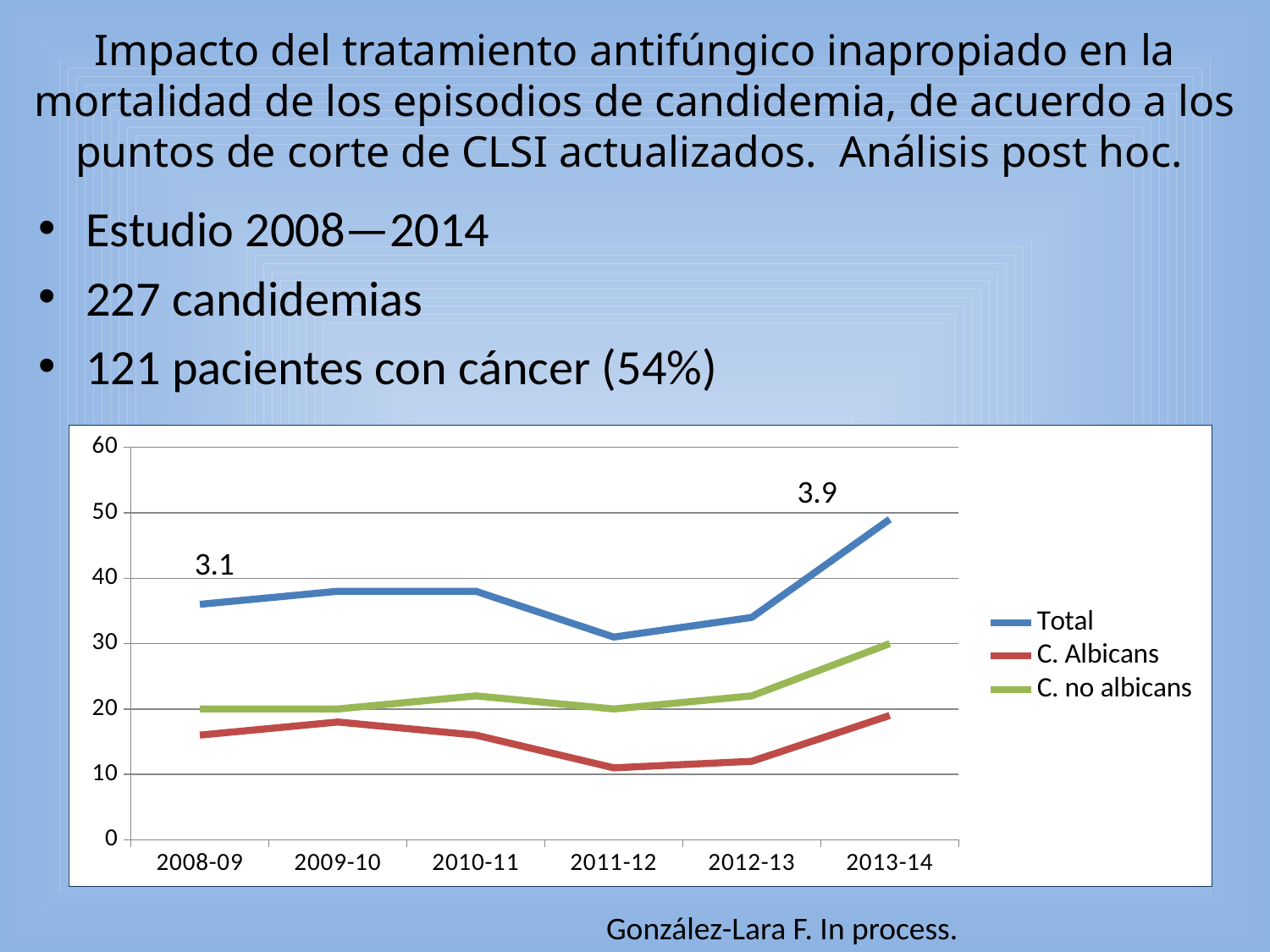
How many periods are shown along the x axis of the chart? 6 What are the three entries listed in the chart legend? Total, C. Albicans, C. no albicans Does the Total series rise or fall from 2012-13 to 2013-14? rise In which period does the Total series reach its highest value? 2013-14 Which is larger in 2013-14, Total or C. no albicans? Total What kind of chart is shown on the slide? line chart How many series does the chart legend list? 3 Is the value for Total in 2013-14 greater or less than 40? greater Is the value for C. Albicans in 2011-12 greater or less than 20? less In which period does the C. Albicans series reach its lowest value? 2011-12 In which period does the C. no albicans series reach its highest value? 2013-14 In which period does the Total series reach its lowest value? 2011-12